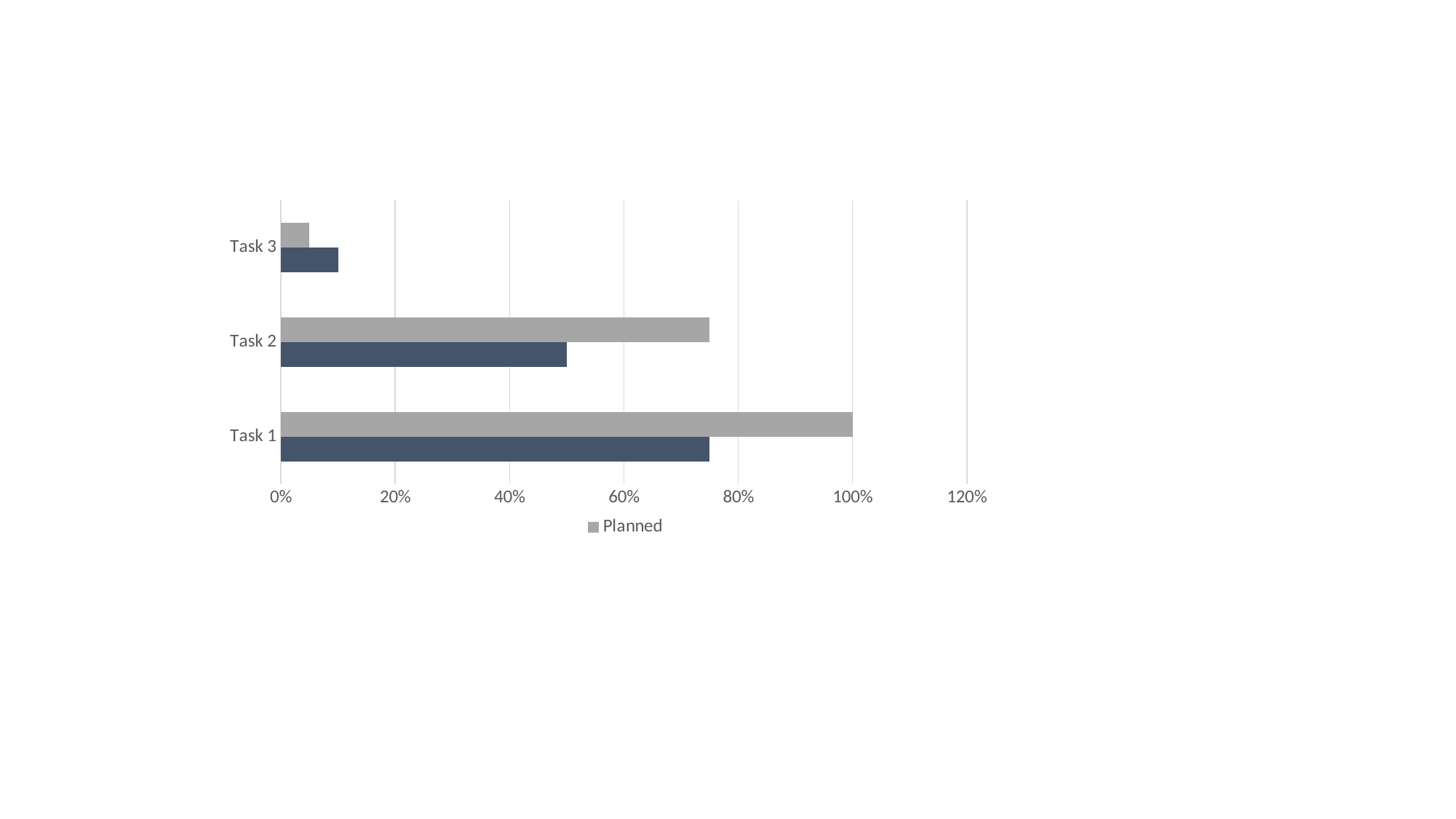
Is the Planned value for Task 2 greater or less than 60%? greater How many series does the legend list? 1 How many tasks are shown on the chart? 3 Which task has the highest Planned value? Task 1 Is the Planned value for Task 3 greater or less than 20%? less What is the Planned value for Task 1? 100% Is the Planned value for Task 2 greater or less than 80%? less Which has a larger Planned value, Task 1 or Task 2? Task 1 Which has a larger Planned value, Task 2 or Task 3? Task 2 What kind of chart is shown on the slide? Bar chart Which task has the lowest Planned value? Task 3 What series name appears in the legend? Planned